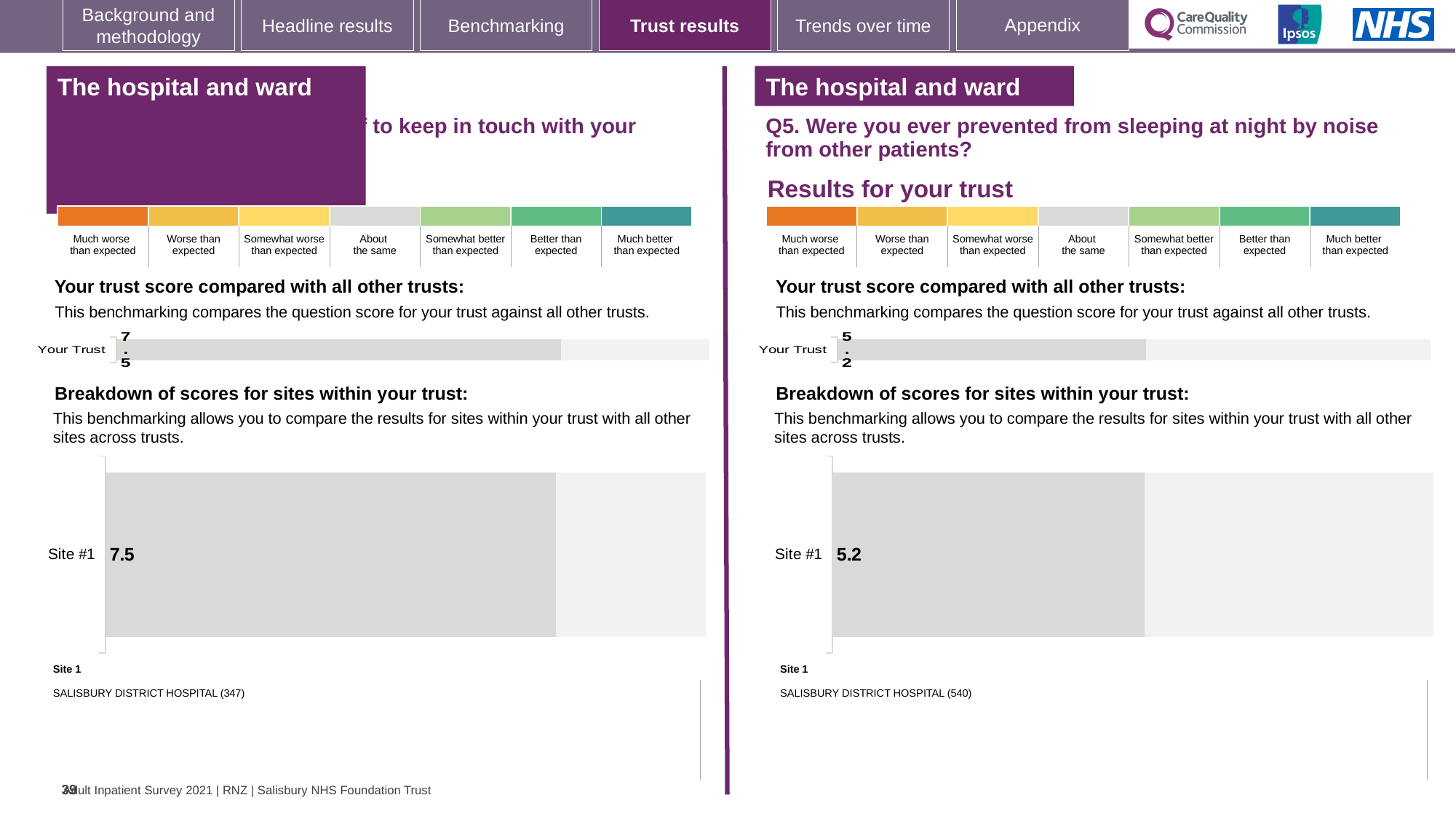
What type of chart is used for the 'Your trust score compared with all other trusts' section on the left half of the slide? Bar chart How many sites are plotted in the 'Breakdown of scores for sites within your trust' chart on the right half of the slide (Q5)? 1 On the left half of the slide, in the 'Your trust score compared with all other trusts' chart, what is the value shown for Your Trust? 7.5 On the right half of the slide (Q5, prevented from sleeping at night by noise from other patients), what is the value shown for Your Trust in the 'Your trust score compared with all other trusts' chart? 5.2 On the right half of the slide (Q5), which hospital is listed as Site 1 below the breakdown chart? SALISBURY DISTRICT HOSPITAL (540) What type of chart is used for the 'Breakdown of scores for sites within your trust' on the right half of the slide (Q5)? Bar chart How many sites are plotted in the 'Breakdown of scores for sites within your trust' chart on the left half of the slide? 1 On the left half of the slide, in the 'Breakdown of scores for sites within your trust' chart, what is the score for Site #1? 7.5 How many categories are shown in the colour key above the 'Your trust score compared with all other trusts' chart on the right half of the slide (Q5)? 7 Which is larger: the Site #1 score in the left-hand breakdown chart or the Site #1 score in the right-hand (Q5) breakdown chart? The left-hand chart (7.5) On the right half of the slide (Q5), in the 'Breakdown of scores for sites within your trust' chart, what is the score for Site #1? 5.2 What is the difference between the Your Trust score on the left half of the slide (7.5) and the Your Trust score on the right half (5.2)? 2.3